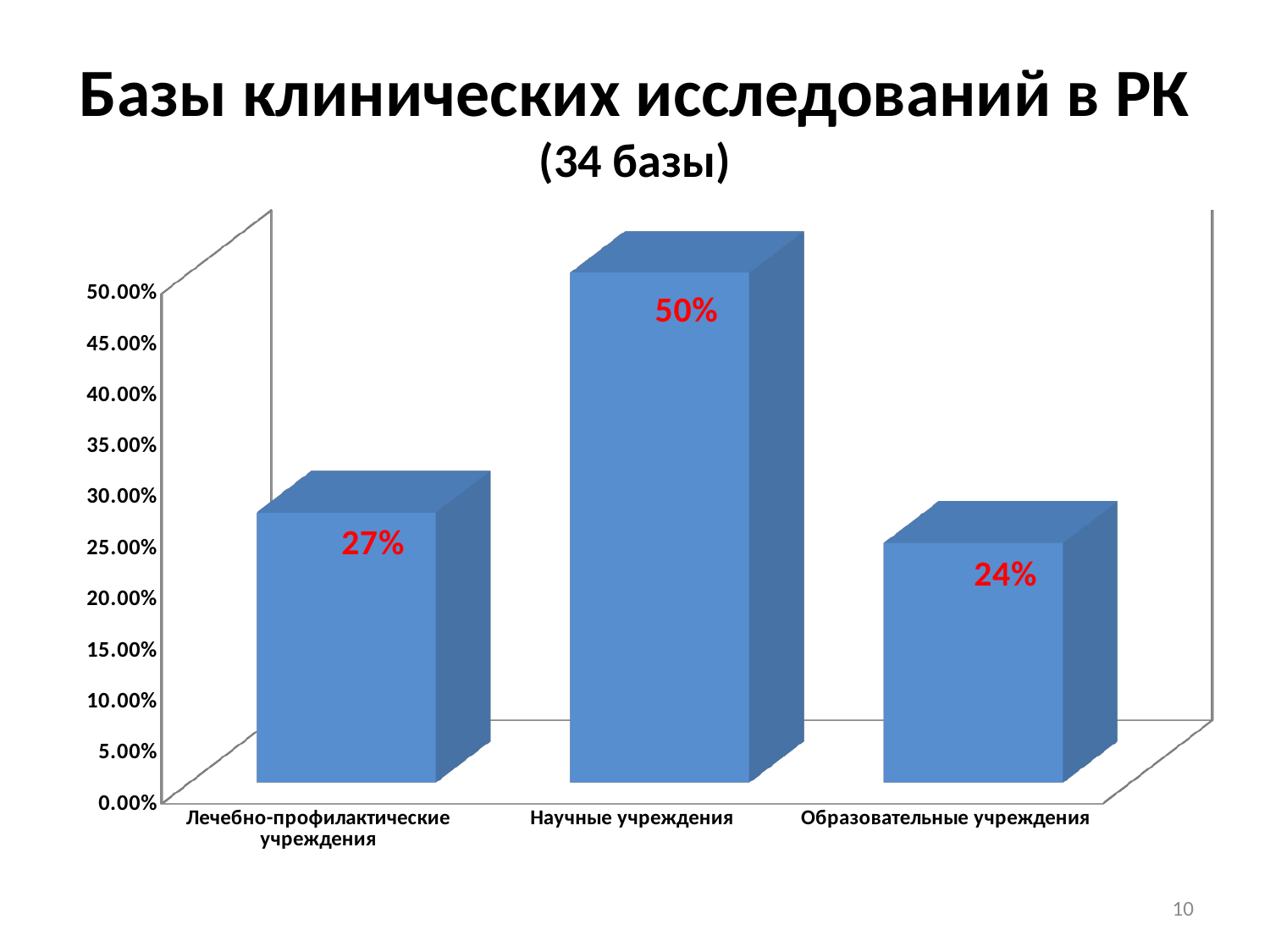
What is the value for Образовательные учреждения? 24% Is the value for Научные учреждения greater or less than 40.00%? greater What is the title of the slide? Базы клинических исследований в РК (34 базы) Which category has the highest value? Научные учреждения What is the value for Лечебно-профилактические учреждения? 27% How many categories are shown in the chart? 3 What is the value for Научные учреждения? 50% Which is larger, the value for Научные учреждения or the value for Образовательные учреждения? Научные учреждения Which category has the lowest value? Образовательные учреждения What kind of chart is shown on the slide? bar chart What is the difference between the values for Лечебно-профилактические учреждения and Образовательные учреждения? 3% What is the difference between the values for Научные учреждения and Лечебно-профилактические учреждения? 23%